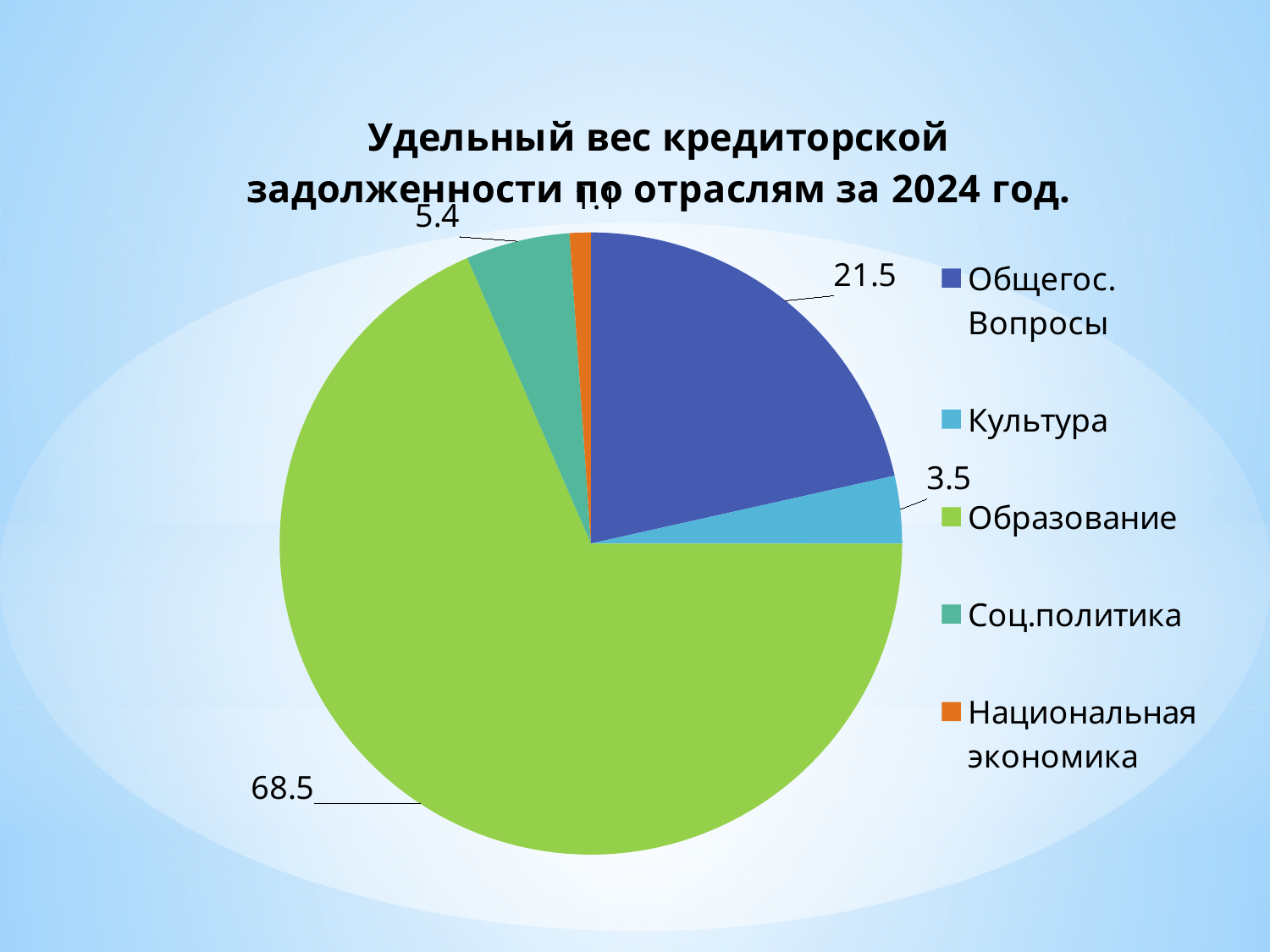
Which category has the largest slice of the pie? Образование How many categories does the legend list? 5 What is the value shown for Общегос. Вопросы? 21.5 What is the title of the chart? Удельный вес кредиторской задолженности по отраслям за 2024 год. What colour is the slice for Образование? Green Which is larger, the value for Соц.политика or the value for Культура? Соц.политика What is the difference between the values for Образование and Общегос. Вопросы? 47 What kind of chart is shown on the slide? Pie chart What is the value shown for Культура? 3.5 What is the value shown for Соц.политика? 5.4 What is the value shown for Образование? 68.5 Which category has the smallest slice of the pie? Национальная экономика